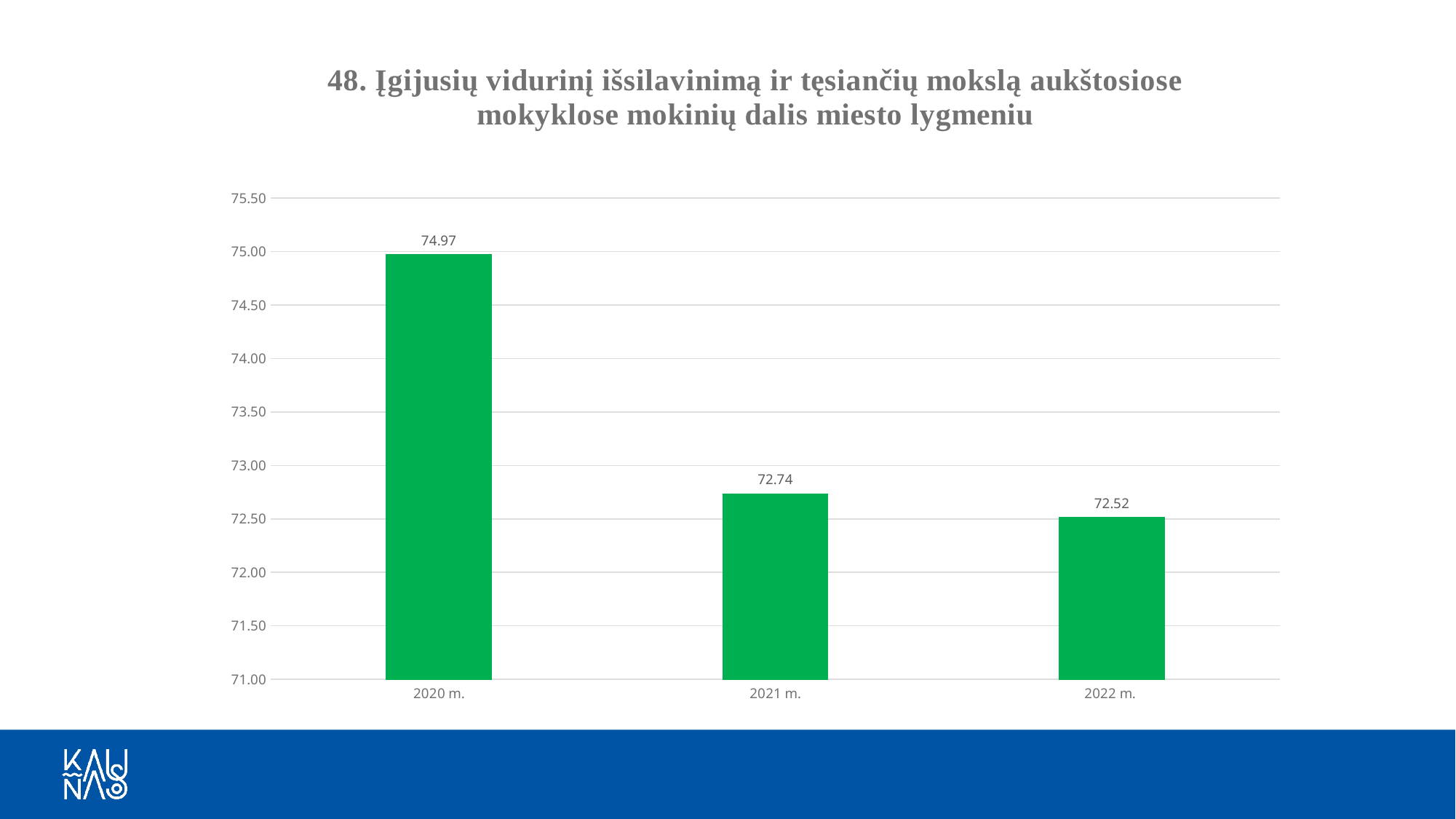
What is the difference between the values for 2021 m. and 2022 m.? 0.22 Which year has the highest value? 2020 m. Is the value for 2020 m. greater or less than 74.50? greater What is the value for 2022 m.? 72.52 What is the difference between the values for 2020 m. and 2021 m.? 2.23 Do the values rise or fall from 2020 m. to 2022 m.? fall Which is larger, the value for 2021 m. or the value for 2022 m.? 2021 m. Which year has the lowest value? 2022 m. How many bars are shown in the chart? 3 What is the value for 2020 m.? 74.97 What kind of chart is shown on the slide? bar chart What is the value for 2021 m.? 72.74